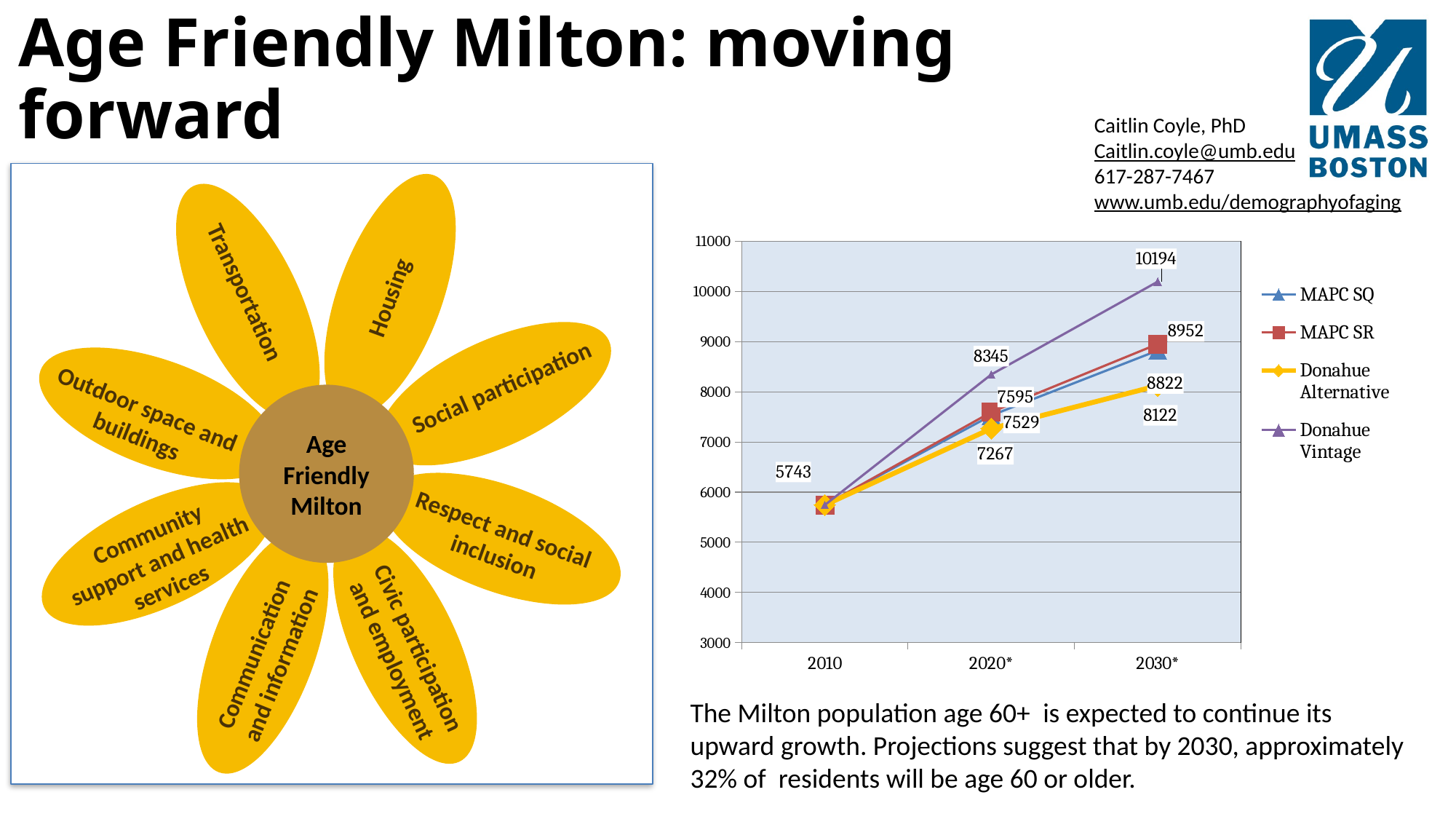
Do the values in the chart rise or fall from 2010 to 2030*? rise What is the difference between the Donahue Vintage value and the MAPC SR value in 2030*? 1242 What type of chart is shown on the right side of the slide? line chart What is the value for MAPC SR in 2030*? 8952 Which series has the highest value in 2030*? Donahue Vintage What is the value for Donahue Vintage in 2030*? 10194 What is the value shown for 2010 on the chart? 5743 Which series has the lowest value in 2030*? Donahue Alternative What is the value for Donahue Vintage in 2020*? 8345 Is the value for Donahue Alternative in 2030* greater or less than 9000? less How many years are shown on the x axis of the chart? 3 How many series does the chart legend list? 4